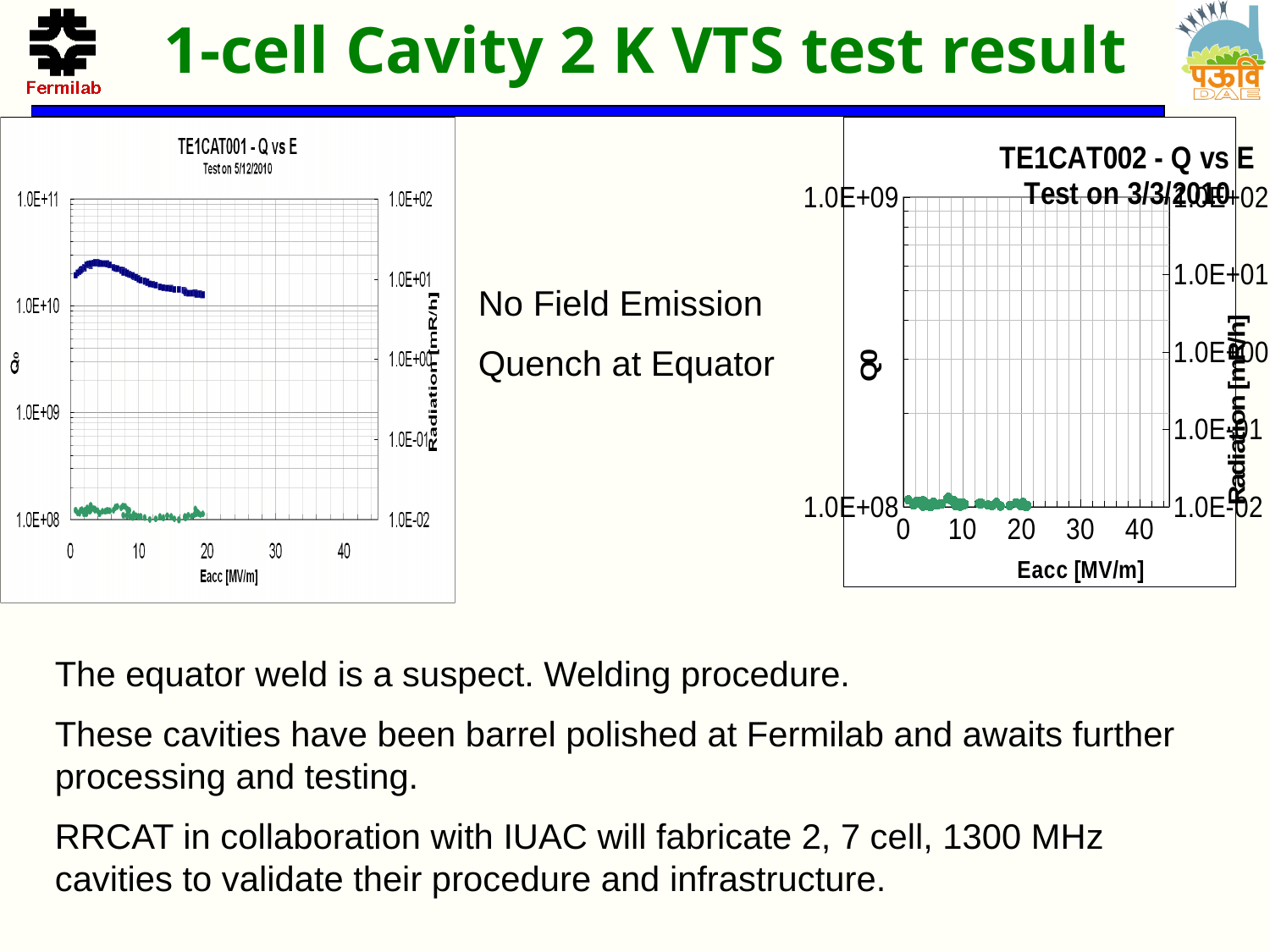
In the left chart (TE1CAT001 - Q vs E), is the Q0 value at 10 MV/m greater or less than 1.0E+11? less What kind of chart is the left chart titled 'TE1CAT001 - Q vs E'? Scatter plot In the left chart (TE1CAT001 - Q vs E), is the radiation level at 10 MV/m greater or less than 1.0E-01 mR/h? less In the left chart (TE1CAT001 - Q vs E), does Q0 rise or fall as Eacc increases from 5 MV/m to 20 MV/m? fall In the left chart (TE1CAT001 - Q vs E), is the Q0 value at 10 MV/m greater or less than 1.0E+10? greater What is the x-axis label of the left chart (TE1CAT001 - Q vs E)? Eacc [MV/m] What is the label of the right-hand vertical axis of the right chart (TE1CAT002 - Q vs E)? Radiation [mR/h] On what date was the test shown in the left chart (TE1CAT001) performed? 5/12/2010 What is the title of the right chart? TE1CAT002 - Q vs E What is the highest tick value shown on the x-axis of the right chart (TE1CAT002 - Q vs E)? 40